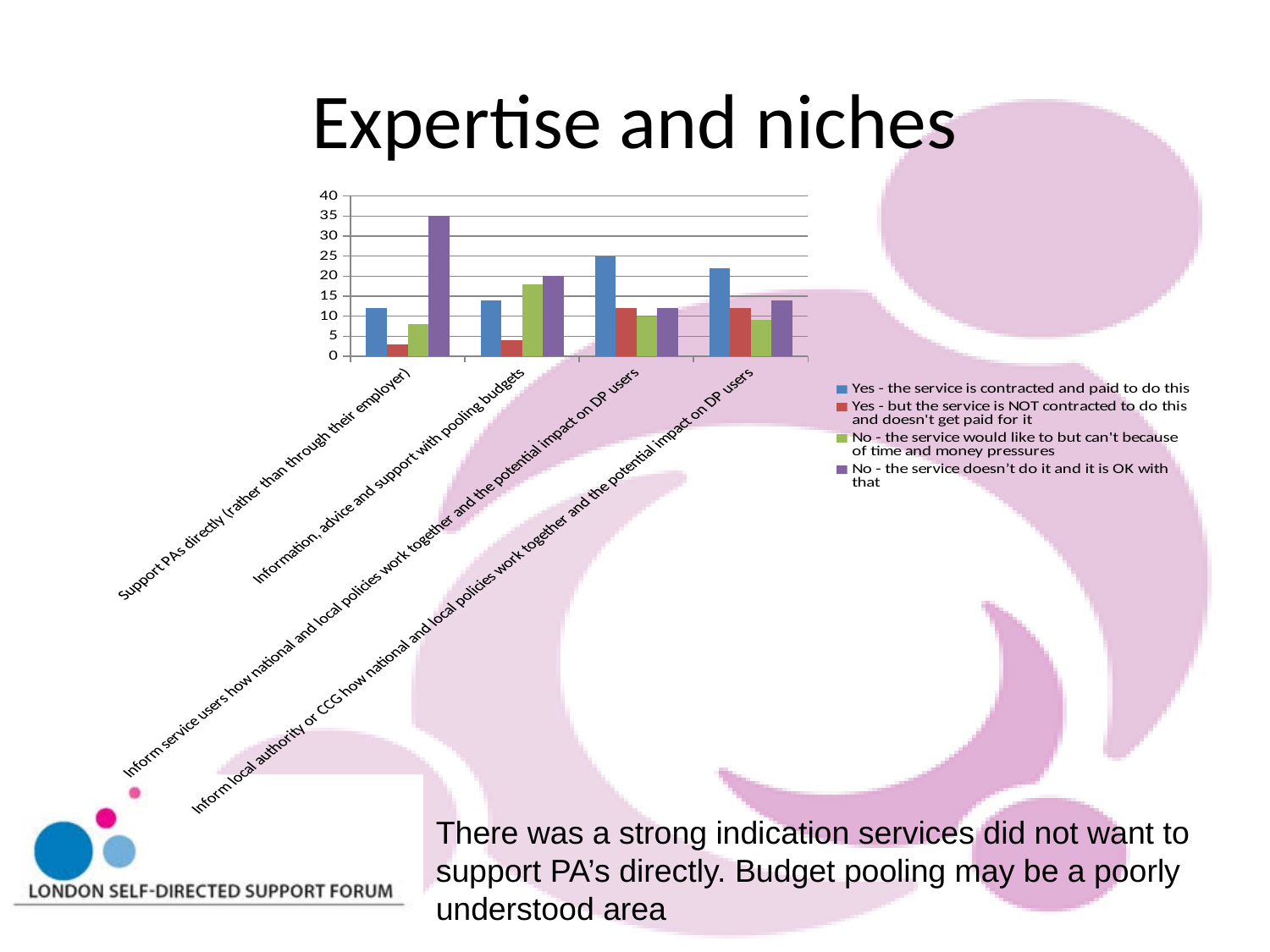
Is the value of 'Yes - the service is contracted and paid to do this' for 'Inform local authority or CCG how national and local policies work together and the potential impact on DP users' greater or less than 20? greater Is the value of 'No - the service would like to but can't because of time and money pressures' for 'Information, advice and support with pooling budgets' greater or less than 15? greater Is the value of 'Yes - but the service is NOT contracted to do this and doesn't get paid for it' for 'Support PAs directly (rather than through their employer)' greater or less than 5? less What kind of chart is shown on the slide? bar chart For 'Inform service users how national and local policies work together and the potential impact on DP users', which is larger: 'Yes - the service is contracted and paid to do this' or 'Yes - but the service is NOT contracted to do this and doesn't get paid for it'? Yes - the service is contracted and paid to do this What is the value of 'Yes - the service is contracted and paid to do this' for 'Inform service users how national and local policies work together and the potential impact on DP users'? 25 Which series has the highest value for 'Support PAs directly (rather than through their employer)'? No - the service doesn't do it and it is OK with that How many categories are shown on the x axis of the chart? 4 How many series does the chart legend list? 4 What is the value of 'No - the service doesn't do it and it is OK with that' for 'Support PAs directly (rather than through their employer)'? 35 Which series has the lowest value for 'Support PAs directly (rather than through their employer)'? Yes - but the service is NOT contracted to do this and doesn't get paid for it What colour represents 'Yes - the service is contracted and paid to do this' in the chart legend? blue